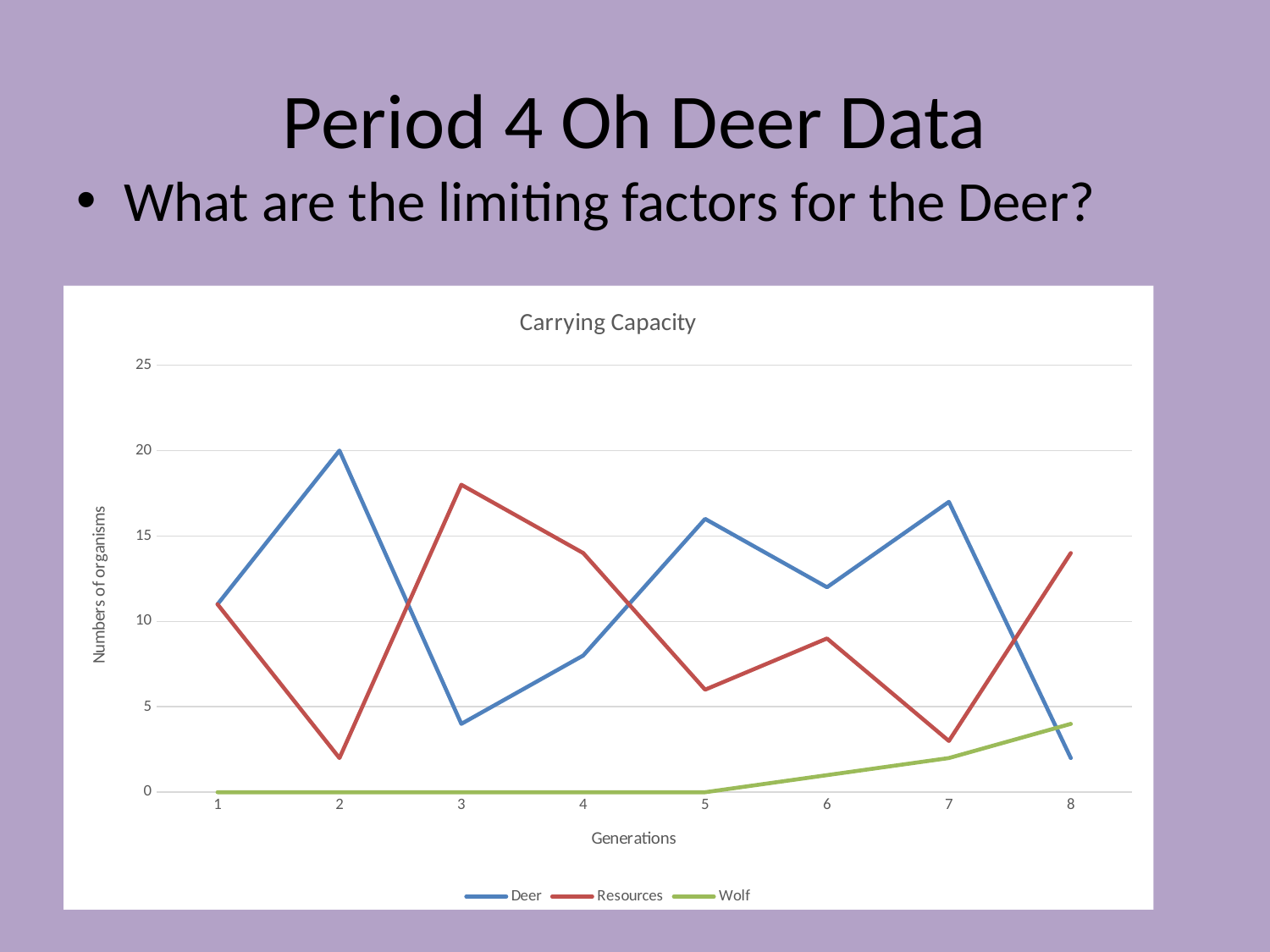
At which generation is the Deer value highest? 2 What is the title of the chart? Carrying Capacity How many generations are plotted on the x axis? 8 What type of chart is shown on the slide? line chart Is the value for Deer at generation 3 greater or less than 5? less At which generation is the Wolf value highest? 8 Is the value for Resources at generation 3 greater or less than 15? greater At generation 8, which is larger, Deer or Resources? Resources What is the value for Deer at generation 2? 20 How many series does the legend list? 3 At which generation is the Resources value highest? 3 What is the value for Wolf at generation 1? 0